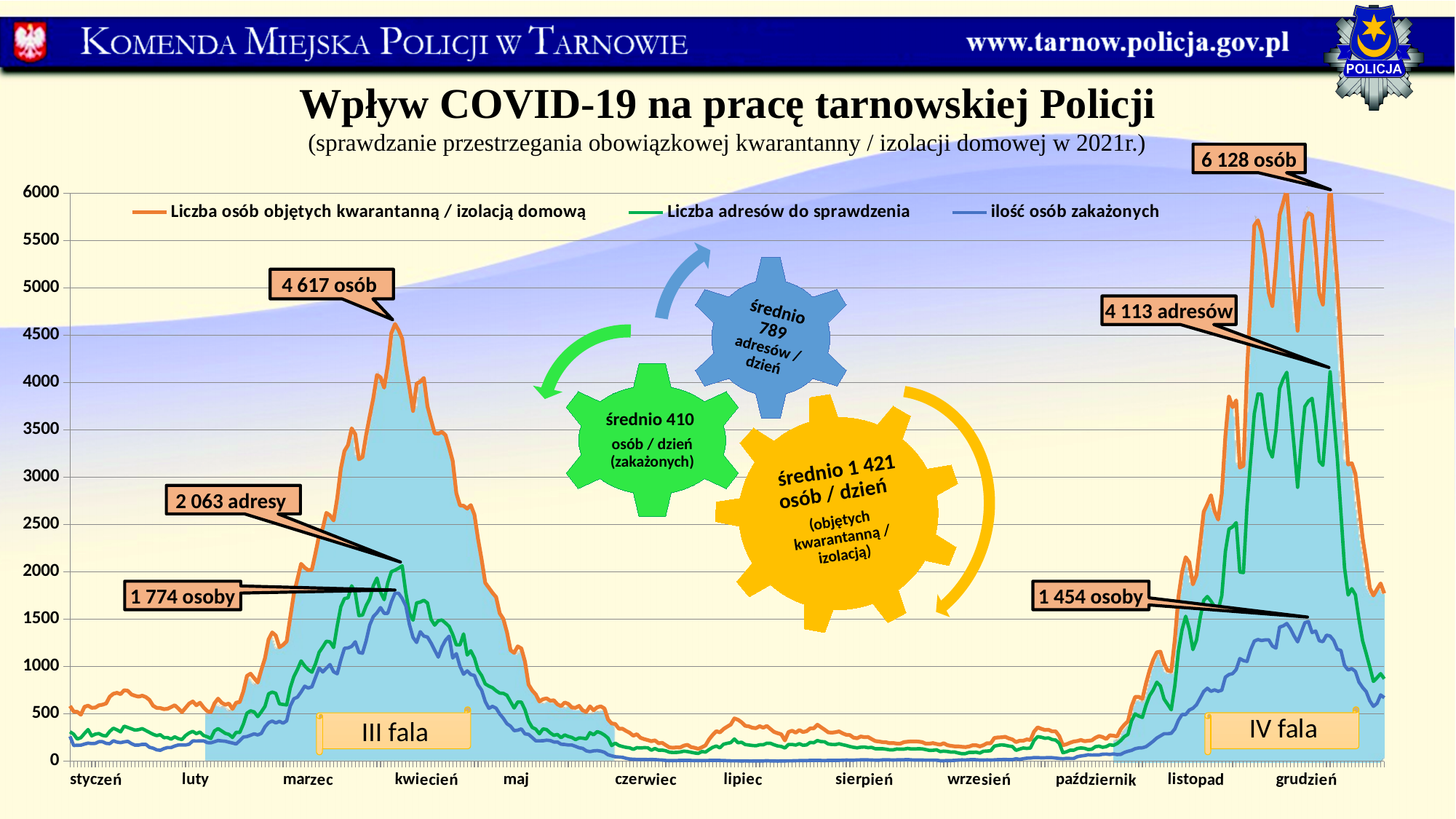
What is the labelled peak value of 'ilość osób zakażonych' during the III fala? 1 774 osoby Which wave had the higher labelled peak of 'ilość osób zakażonych', III fala or IV fala? III fala What is the labelled peak value of 'Liczba adresów do sprawdzenia' during the III fala? 2 063 adresy How many series does the chart legend list? 3 Is the value of 'Liczba osób objętych kwarantanną / izolacją domową' in sierpień greater or less than 500? less What is the labelled peak value of 'Liczba adresów do sprawdzenia' during the IV fala? 4 113 adresów What is the labelled peak value of the series 'Liczba osób objętych kwarantanną / izolacją domową' during the III fala? 4 617 osób By how much does the IV fala peak of persons in quarantine/isolation (6 128) exceed the III fala peak (4 617)? 1 511 What is the labelled peak value of the series 'Liczba osób objętych kwarantanną / izolacją domową' during the IV fala? 6 128 osób What is the labelled peak value of 'ilość osób zakażonych' during the IV fala? 1 454 osoby According to the gear graphic, what is the average number of addresses to check per day (średnio adresów / dzień)? 789 What type of chart is shown on the slide? line chart